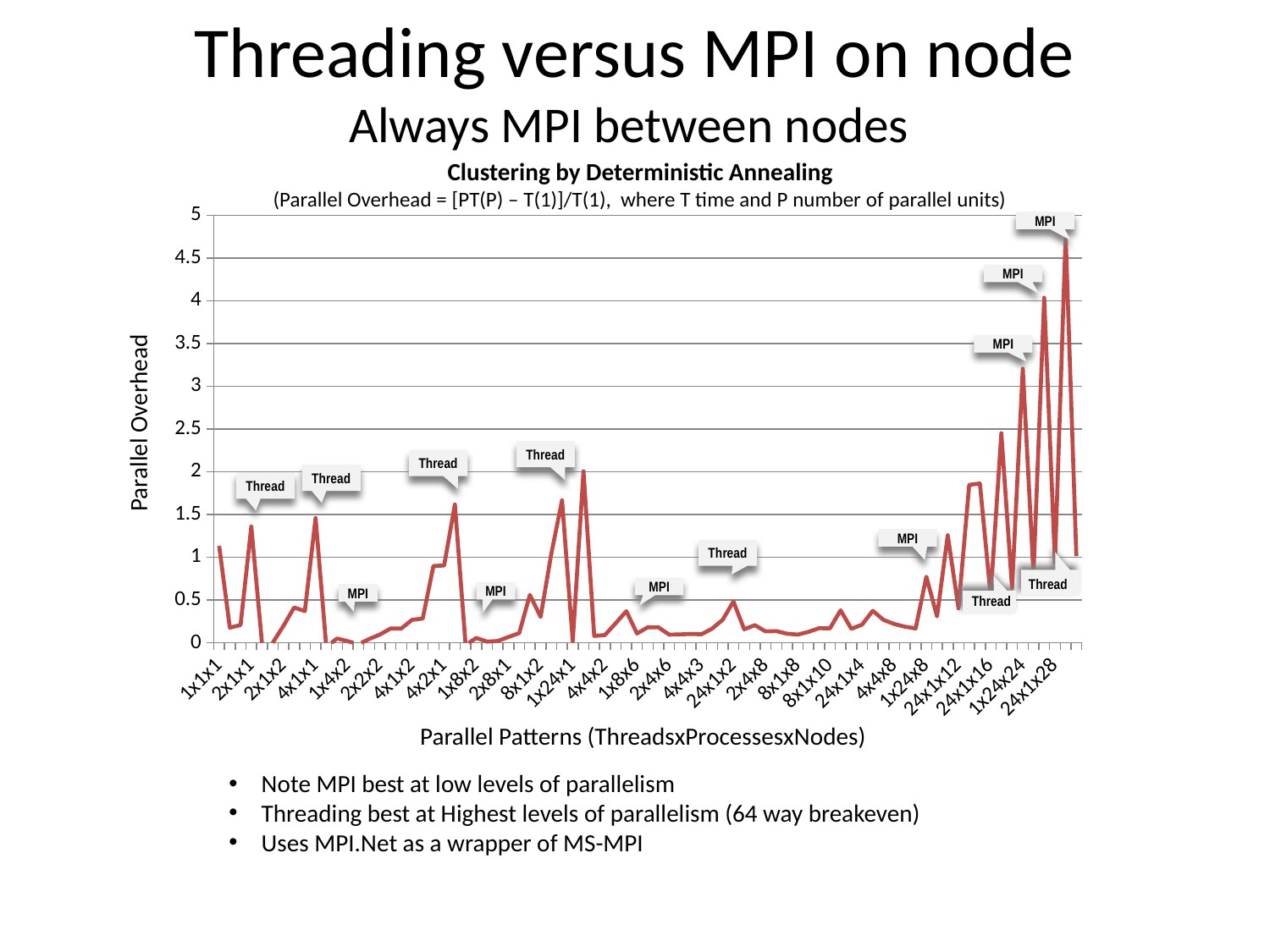
Is the highest value plotted on the chart greater or less than 4? greater Is the value for 1x4x2 greater or less than 0.5? less What kind of chart is shown on the slide? line chart Which is larger, the value for 24x1x12 or the value for 2x4x8? 24x1x12 What is the title of the chart? Clustering by Deterministic Annealing Is the value for 24x1x16 greater or less than 2? less What is the label of the x axis of the chart? Parallel Patterns (ThreadsxProcessesxNodes)